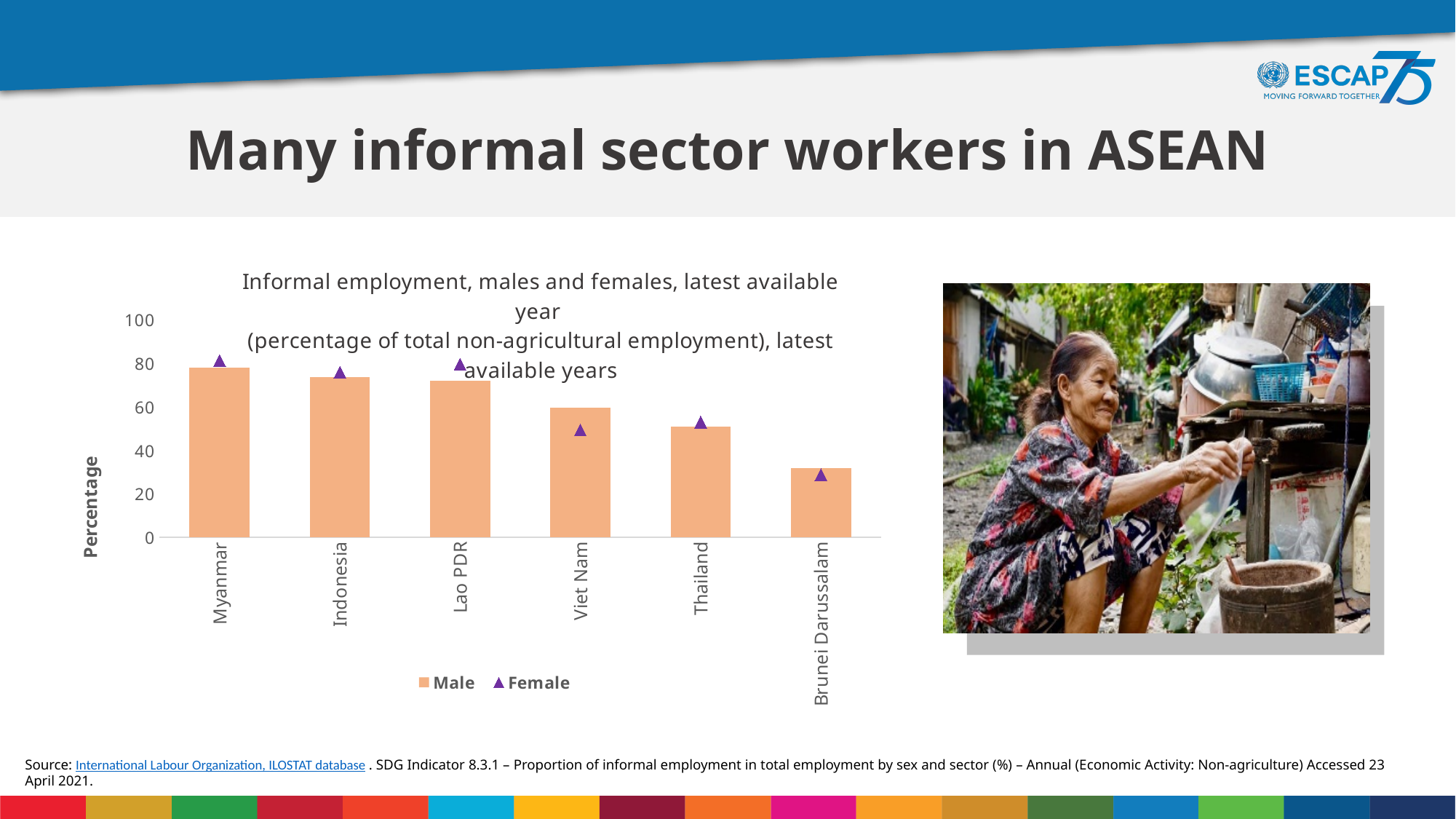
What kind of chart is shown on the slide? Bar chart What is the label on the vertical axis of the chart? Percentage Which country has the highest Male bar in the chart? Myanmar How many countries are shown on the x axis of the chart? 6 Do the Male bars rise or fall from left to right across the countries? Fall How many series does the chart legend list? 2 Is the Male value for Lao PDR greater or less than 60? greater Which series in the chart is shown with triangle markers? Female Which country has the lowest Male bar in the chart? Brunei Darussalam Which has the larger Male value, Viet Nam or Thailand? Viet Nam Is the Male value for Brunei Darussalam greater or less than 40? less Is the Male value for Thailand greater or less than 60? less